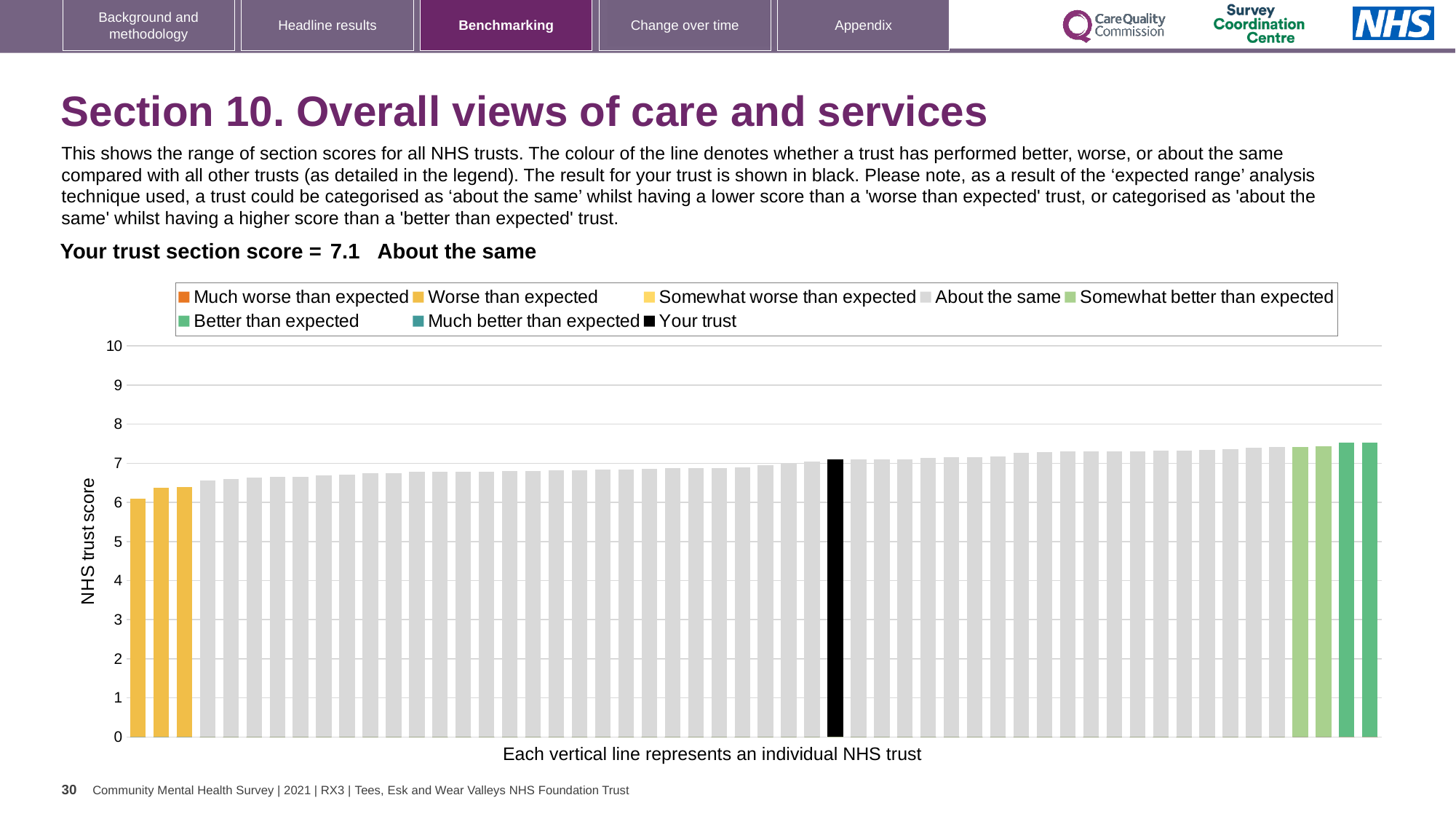
Which legend category does the highest bar on the chart belong to? Better than expected Do the bar values rise or fall from left to right along the x axis? rise Is the value of the lowest bar greater or less than 5? greater What is the section score for your trust shown on the slide? 7.1 Is the value of the highest bar greater or less than 8? less Is the value for your trust (the black bar) greater or less than 6? greater What is the label on the vertical axis of the chart? NHS trust score How many entries does the chart legend list? 8 What kind of chart is shown on the slide? bar chart Which legend category does the lowest bar on the chart belong to? Worse than expected How many bars are coloured as 'Worse than expected'? 3 Which performance category is your trust placed in for this section? About the same